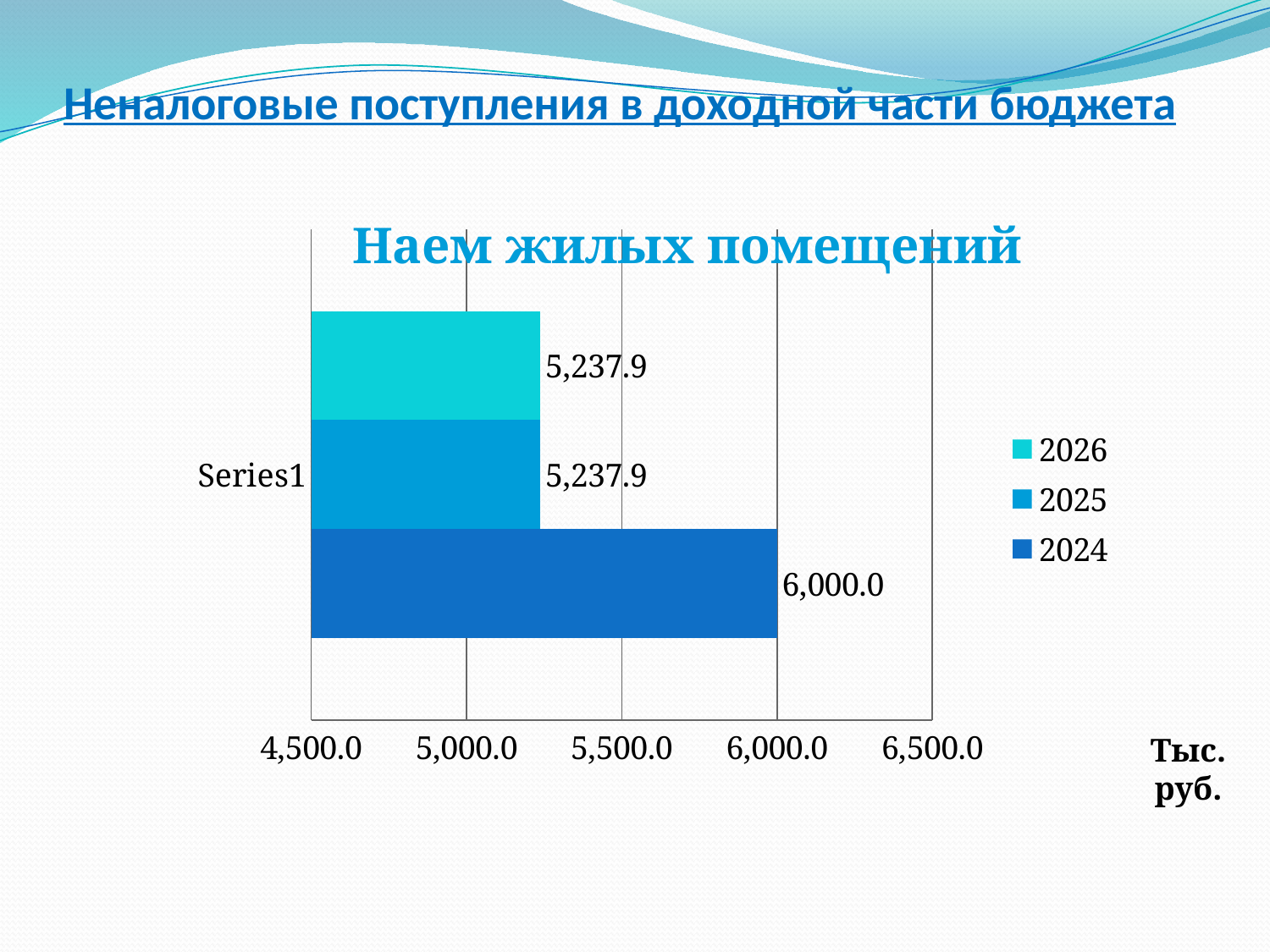
What unit is indicated next to the chart's axis? Тыс. руб. How many series does the legend list? 3 What is the difference between the values for 2024 and 2025? 762.1 Which is larger, the value for 2024 or the value for 2026? 2024 What is the value for 2025 in the chart? 5,237.9 Is the value for 2024 greater or less than 5,500.0? greater What is the value for 2024 in the chart? 6,000.0 What kind of chart is shown on the slide? bar chart What is the title of the chart? Наем жилых помещений Which year has the highest value in the chart? 2024 Is the value for 2025 greater or less than 5,500.0? less What is the value for 2026 in the chart? 5,237.9